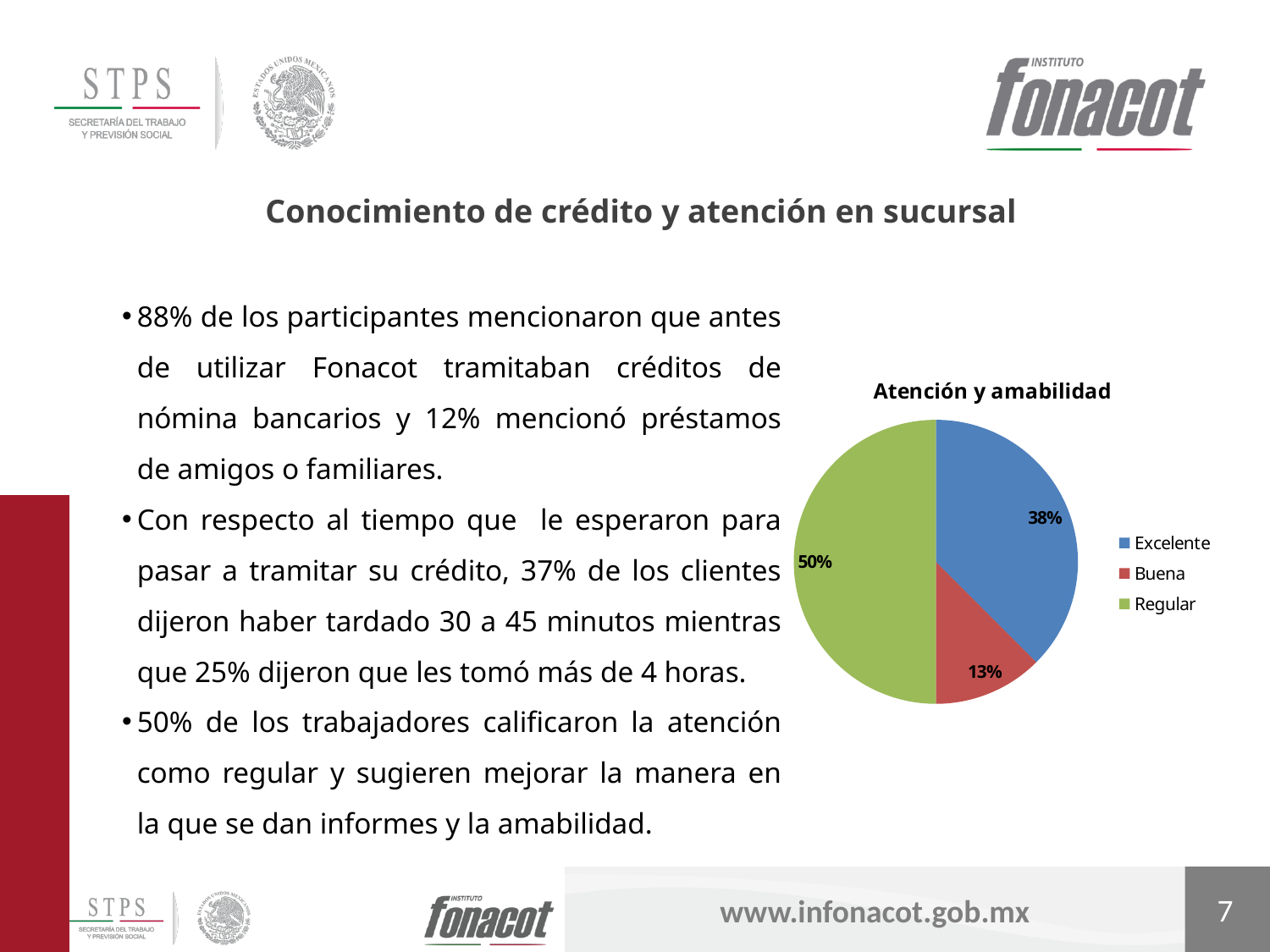
What type of chart is shown on the slide? pie chart What share of the pie does Excelente represent? 38% What share of the pie does Buena represent? 13% Which category has the largest slice of the pie? Regular How many entries does the legend list? 3 What share of the pie does Regular represent? 50% What is the difference between the Regular share and the Excelente share? 12% What is the title of the pie chart? Atención y amabilidad Which is larger, the share for Excelente or the share for Buena? Excelente What colour is the Regular slice in the pie chart? green Which category has the smallest slice of the pie? Buena How many categories does the pie chart show? 3